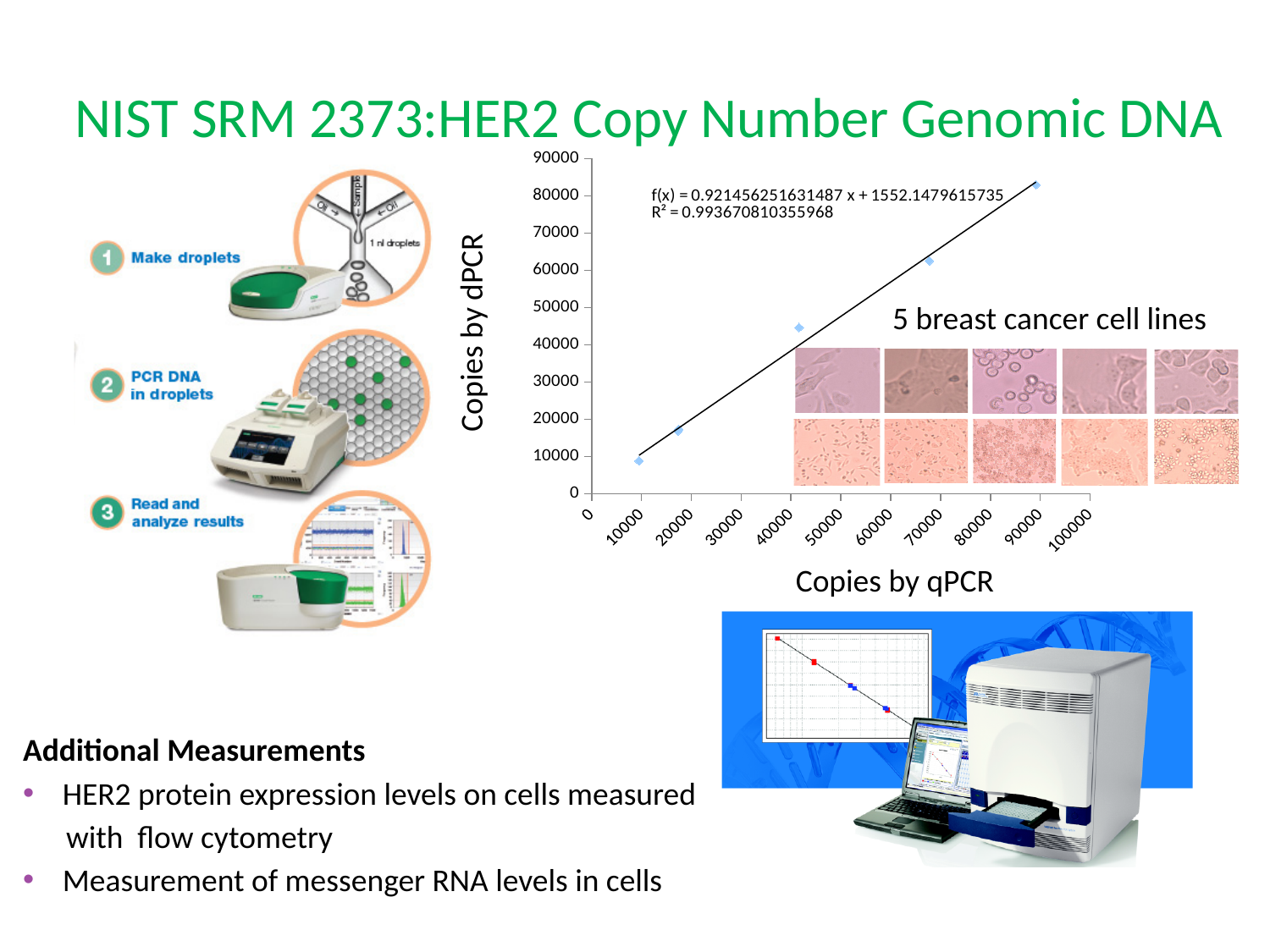
Do the Copies by dPCR values rise or fall as Copies by qPCR increases along the x axis? Rise Which point has the higher Copies by dPCR value: the one near 20000 Copies by qPCR or the one near 40000 Copies by qPCR? The one near 40000 Copies by qPCR Is the Copies by dPCR value for the point near 70000 Copies by qPCR greater or less than 70000? less Is the Copies by dPCR value for the point with the highest Copies by qPCR greater or less than 80000? greater What kind of chart is shown on the slide? Scatter chart What is the label of the y axis of the chart? Copies by dPCR Is the Copies by dPCR value for the point with the lowest Copies by qPCR greater or less than 10000? less Does the point with the highest Copies by qPCR also have the highest Copies by dPCR? Yes What is the R² value printed on the chart? 0.993670810355968